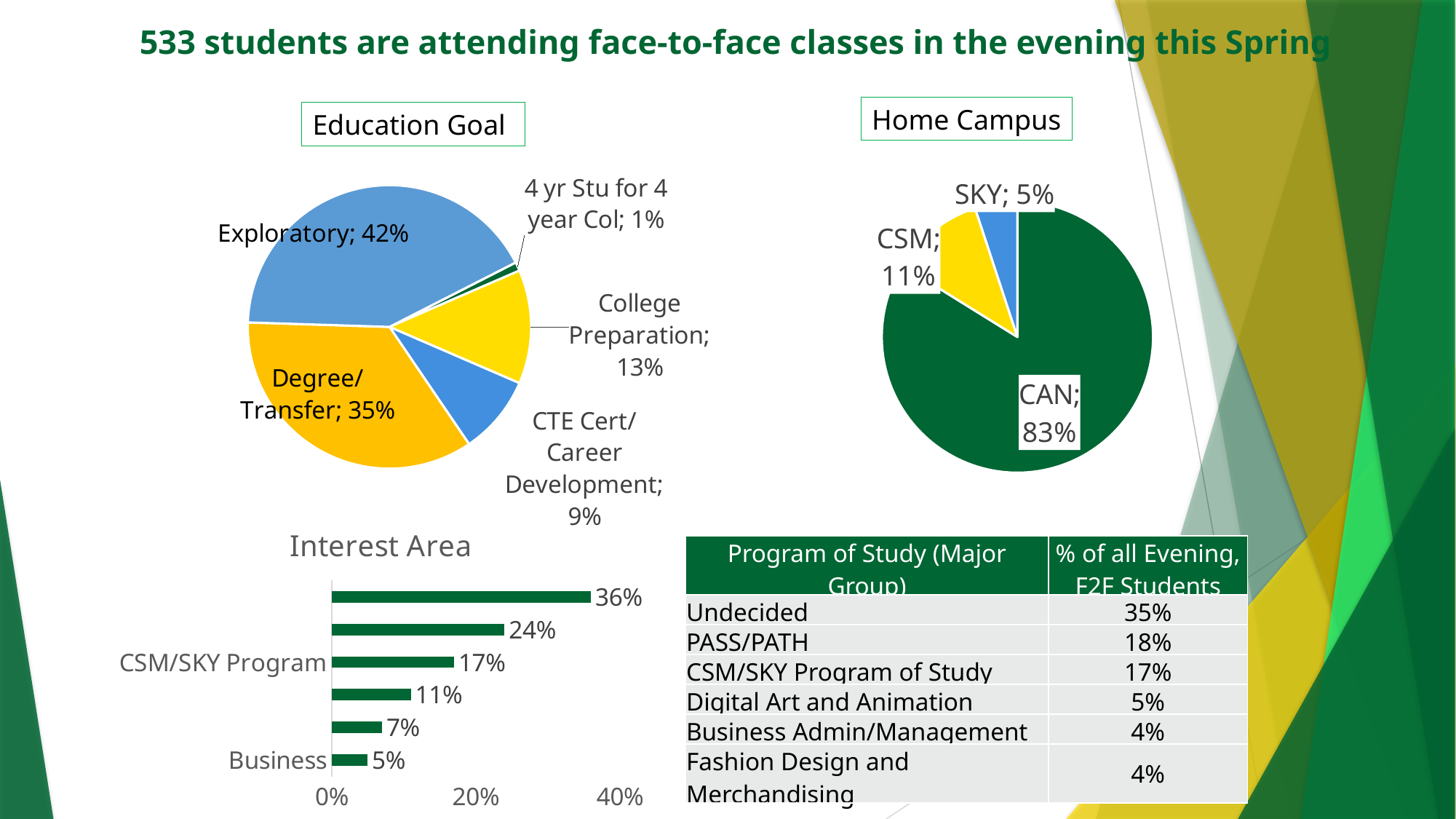
In the Home Campus pie chart, which is larger, CSM or SKY? CSM In the Interest Area chart, what is the value for Business? 5% In the Home Campus pie chart, what percentage is shown for CAN? 83% How many categories are shown in the Home Campus chart? 3 What type of chart is the Interest Area chart? Bar chart In the Education Goal pie chart, which category has the largest share? Exploratory In the Education Goal pie chart, which category has the smallest share? 4 yr Stu for 4 year Col In the Interest Area chart, what is the value for CSM/SKY Program? 17% What type of chart is the Home Campus chart? Pie chart In the Education Goal pie chart, what is the difference in percentage points between Exploratory and Degree/Transfer? 7 percentage points How many slices does the Education Goal pie chart have? 5 In the Education Goal pie chart, what percentage is shown for Exploratory? 42%